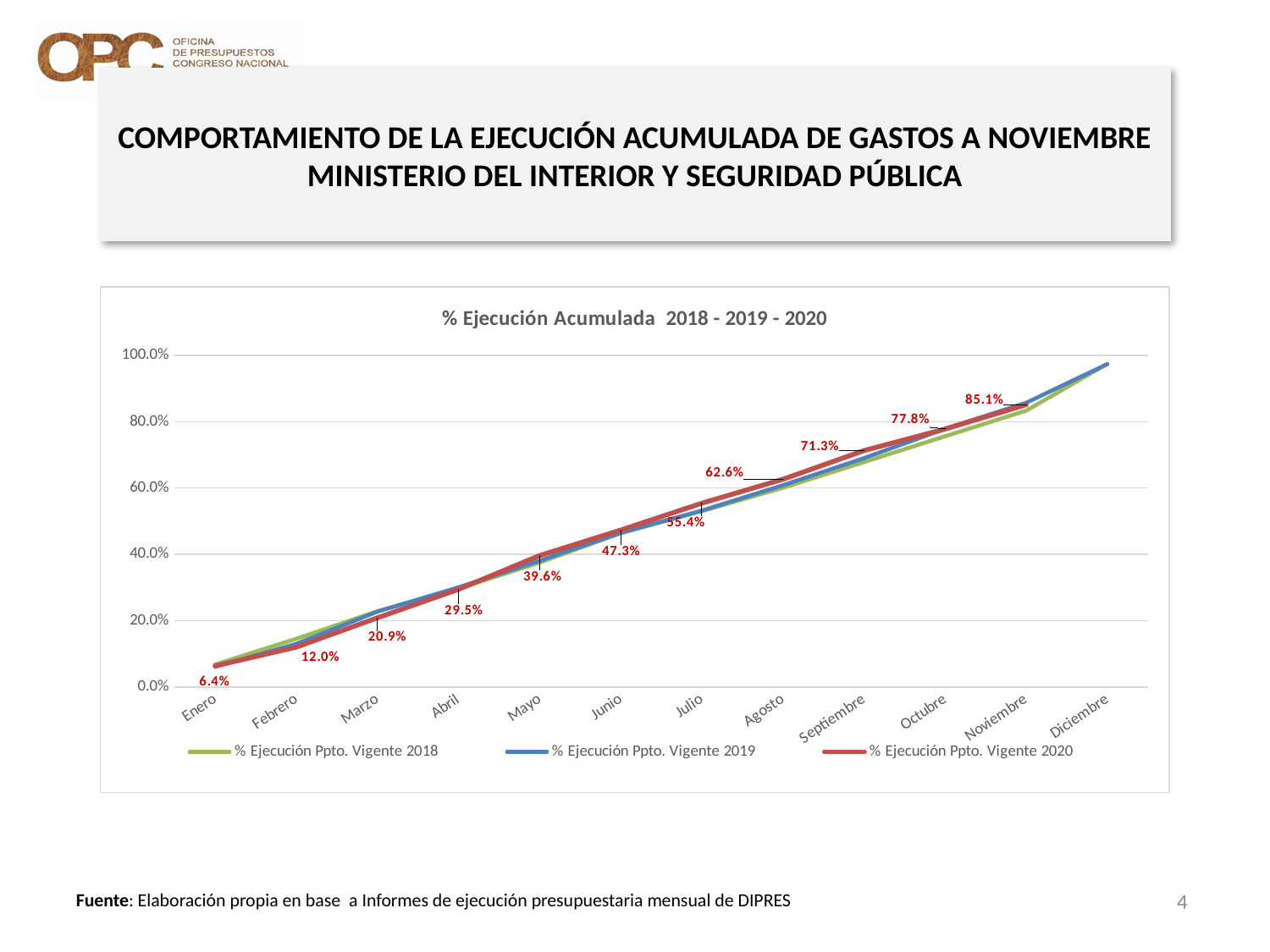
What is the difference in percentage points between the 2020 values for Noviembre (85.1%) and Octubre (77.8%)? 7.3 What kind of chart is shown? line chart Is the 2020 value for Septiembre larger or smaller than the 2020 value for Julio? larger Which month has the highest labelled value for % Ejecución Ppto. Vigente 2020? Noviembre What is the value of % Ejecución Ppto. Vigente 2020 for Enero? 6.4% What is the value of % Ejecución Ppto. Vigente 2020 for Noviembre? 85.1% How many series does the legend list? 3 How many months are shown on the x axis? 12 Is the value for % Ejecución Ppto. Vigente 2019 in Diciembre greater or less than 80.0%? greater What is the value of % Ejecución Ppto. Vigente 2020 for Agosto? 62.6% What is the value of % Ejecución Ppto. Vigente 2020 for Junio? 47.3% Which month has the lowest labelled value for % Ejecución Ppto. Vigente 2020? Enero